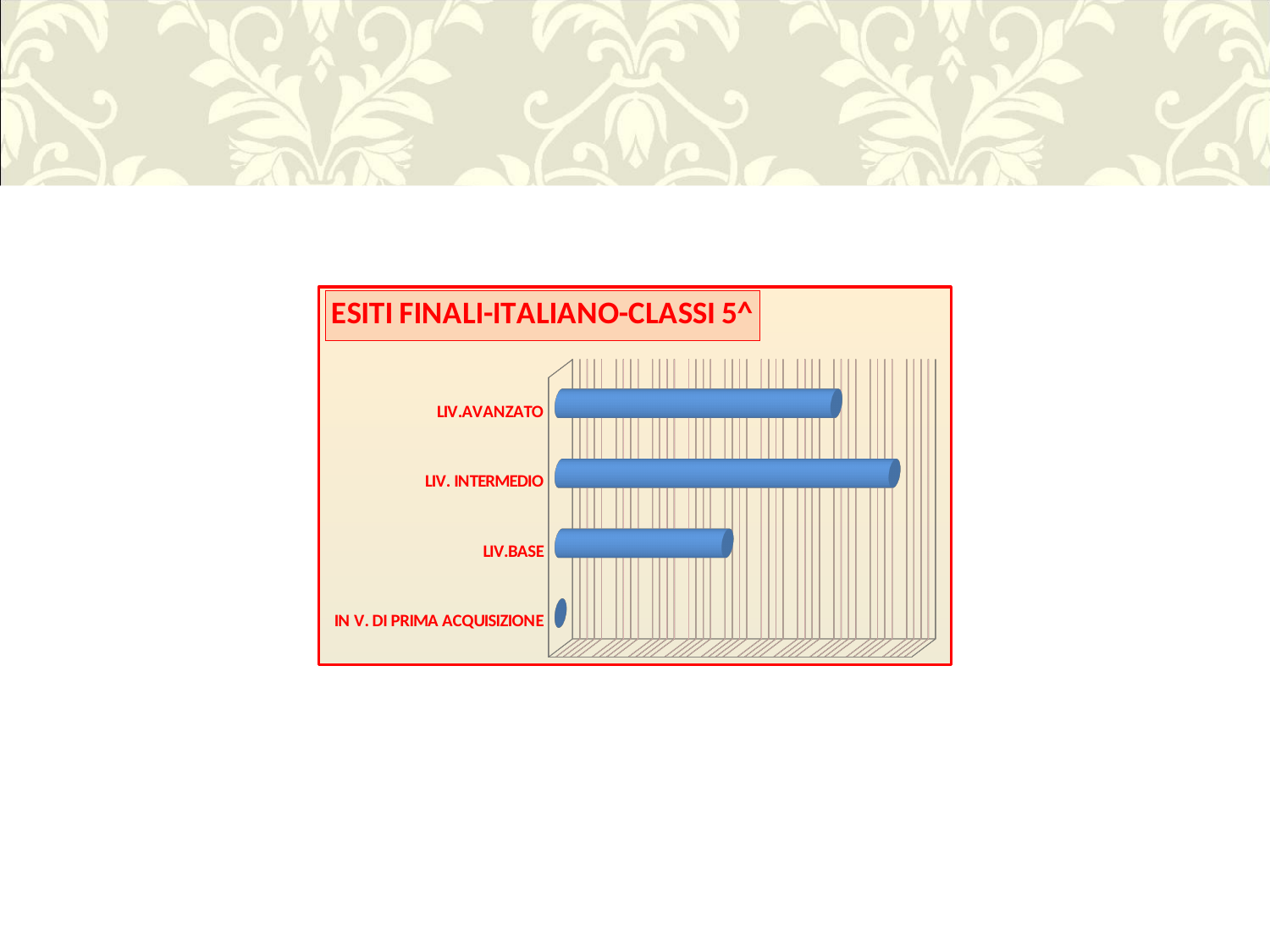
How many categories are plotted in the chart? 4 What kind of chart is shown on the slide? bar chart Which is larger, the value for LIV.BASE or the value for IN V. DI PRIMA ACQUISIZIONE? LIV.BASE Which category has the lowest value in the chart? IN V. DI PRIMA ACQUISIZIONE Which is larger, the value for LIV.AVANZATO or the value for LIV.BASE? LIV.AVANZATO What colour are the bars in the chart? blue What is the title of the chart? ESITI FINALI-ITALIANO-CLASSI 5^ Which is larger, the value for LIV. INTERMEDIO or the value for LIV.AVANZATO? LIV. INTERMEDIO Which category has the highest value in the chart? LIV. INTERMEDIO